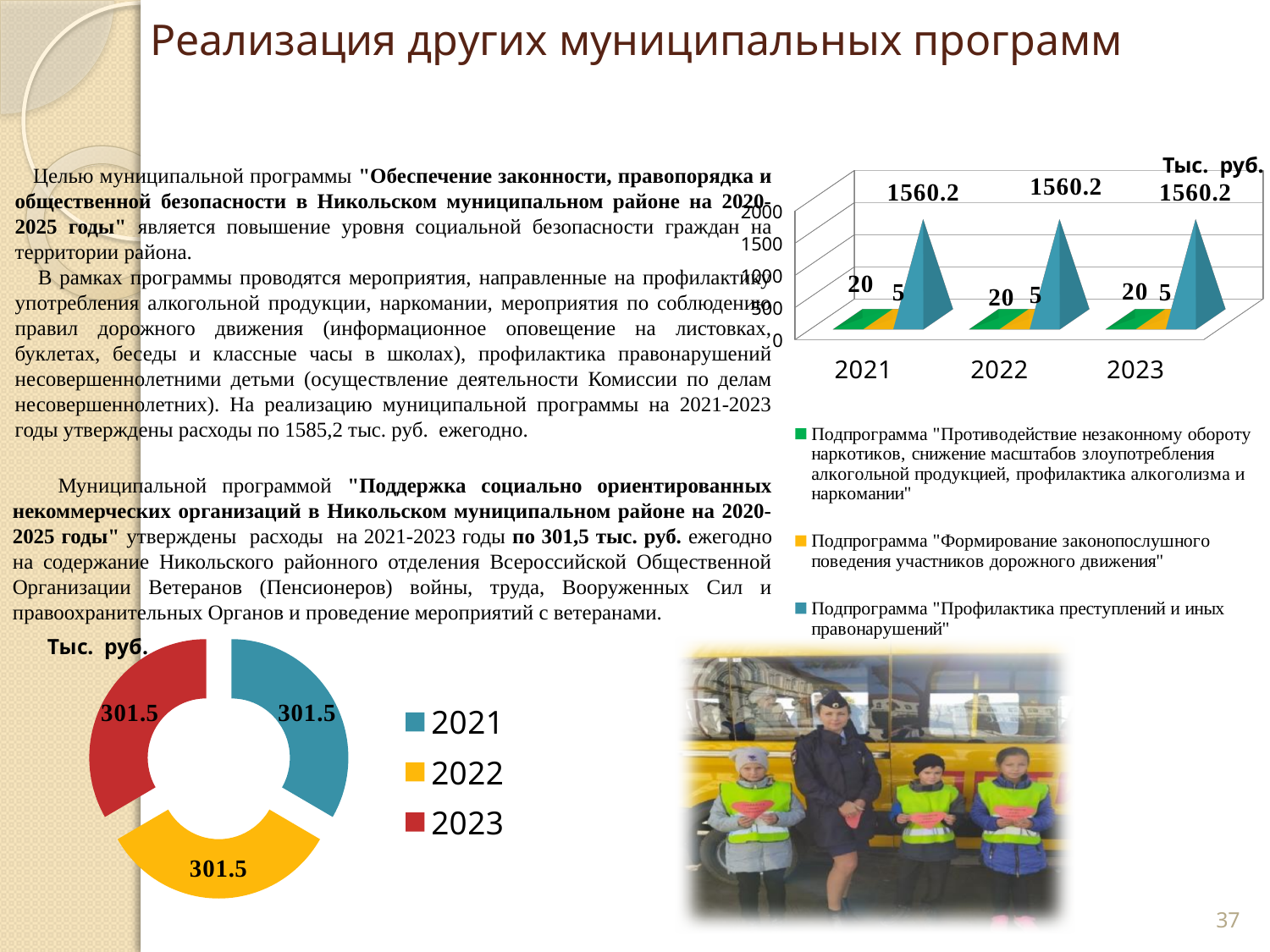
In the bottom-left doughnut chart, what is the value for 2022? 301.5 In the top-right chart, what is the value for the subprogram "Профилактика преступлений и иных правонарушений" in 2022? 1560.2 In the top-right chart, what is the difference between the values for "Профилактика преступлений и иных правонарушений" and "Противодействие незаконному обороту наркотиков..." in 2022? 1540.2 What kind of chart is the bottom-left chart on the slide? doughnut chart In the top-right chart, does the value for "Профилактика преступлений и иных правонарушений" rise, fall or stay the same from 2021 to 2023? stays the same What kind of chart is the top-right chart on the slide? bar chart In the top-right chart, what is the value for the subprogram "Формирование законопослушного поведения участников дорожного движения" in 2023? 5 How many series does the legend of the top-right chart list? 3 In the top-right chart, what is the value for the subprogram "Противодействие незаконному обороту наркотиков..." in 2021? 20 In the bottom-left doughnut chart, what is the total of the three segments? 904.5 In the top-right chart, which subprogram has the lowest value in 2021? Подпрограмма "Формирование законопослушного поведения участников дорожного движения" In the top-right chart, which subprogram has the highest value in 2023? Подпрограмма "Профилактика преступлений и иных правонарушений"